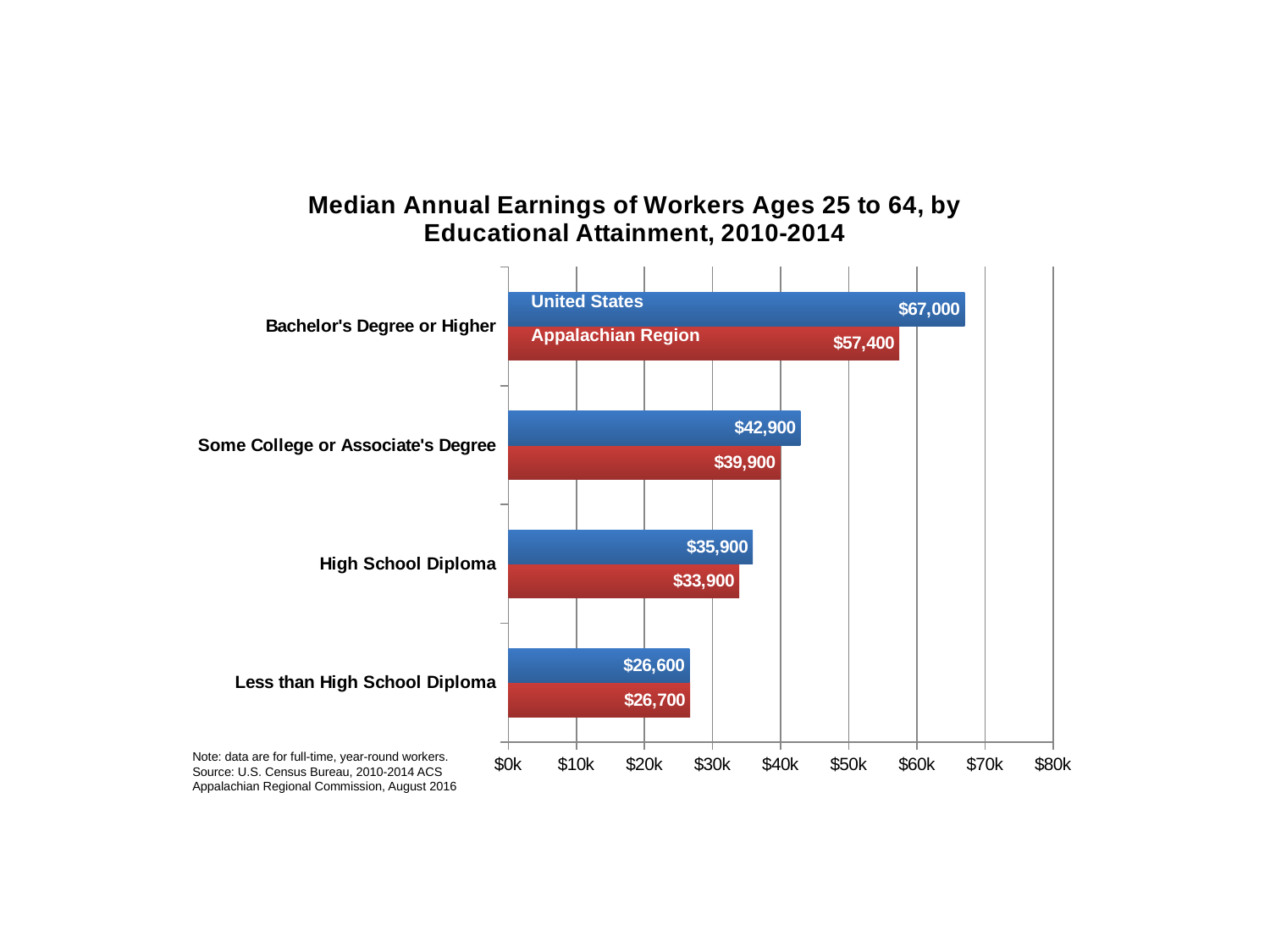
What is the median annual earnings for Appalachian Region workers with Some College or Associate's Degree? $39,900 How many educational attainment categories are shown on the chart? 4 Is the Appalachian Region median earnings for Bachelor's Degree or Higher greater or less than $60k? less What is the median annual earnings for United States workers with a Bachelor's Degree or Higher? $67,000 What is the median annual earnings for Appalachian Region workers with a High School Diploma? $33,900 What type of chart is shown on the slide? Bar chart Which educational attainment category has the highest median annual earnings for the United States? Bachelor's Degree or Higher What is the difference between United States and Appalachian Region median earnings for workers with a Bachelor's Degree or Higher? $9,600 Which educational attainment category has the lowest median annual earnings for the Appalachian Region? Less than High School Diploma How many series does the chart show? 2 What is the difference between United States and Appalachian Region median earnings for workers with Some College or Associate's Degree? $3,000 For workers with a High School Diploma, which is larger: United States or Appalachian Region median earnings? United States